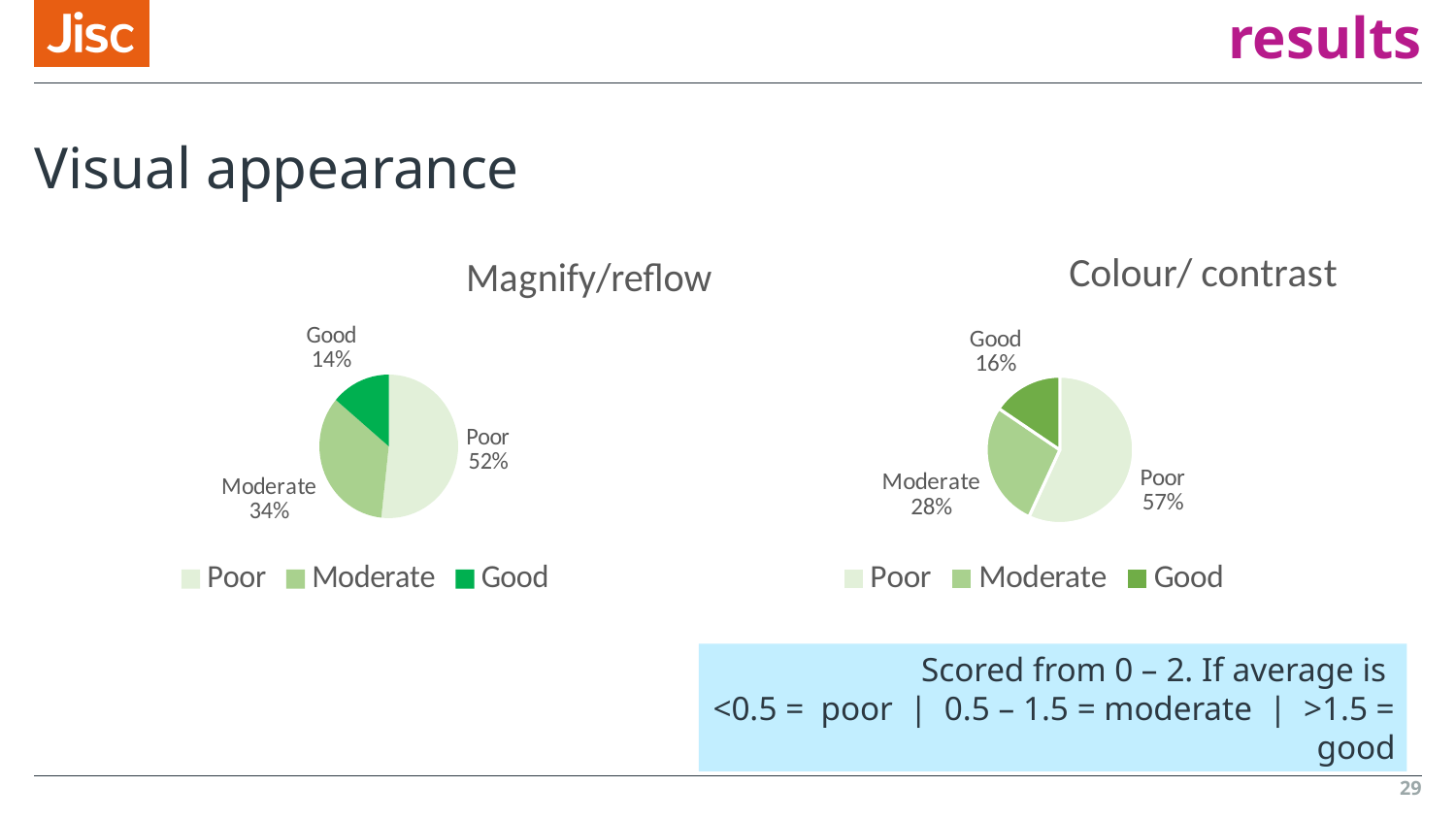
In the Magnify/reflow chart, which category has the largest slice? Poor What are the three legend entries shown under the Colour/ contrast chart? Poor, Moderate, Good In the Magnify/reflow chart, what is the difference between the Poor and Moderate percentages? 18% In the Magnify/reflow chart, what percentage is labelled Poor? 52% In the Colour/ contrast chart, which category has the smallest slice? Good Which chart has the larger Poor share, Magnify/reflow or Colour/ contrast? Colour/ contrast In the Colour/ contrast chart, what percentage is labelled Moderate? 28% What share of the Magnify/reflow pie is labelled Good? 14% How many slices does the Colour/ contrast pie chart have? 3 In the Colour/ contrast chart, what percentage is labelled Good? 16% In the Magnify/reflow chart, is the Moderate slice larger or smaller than the Good slice? larger What type of chart is the Magnify/reflow chart? pie chart